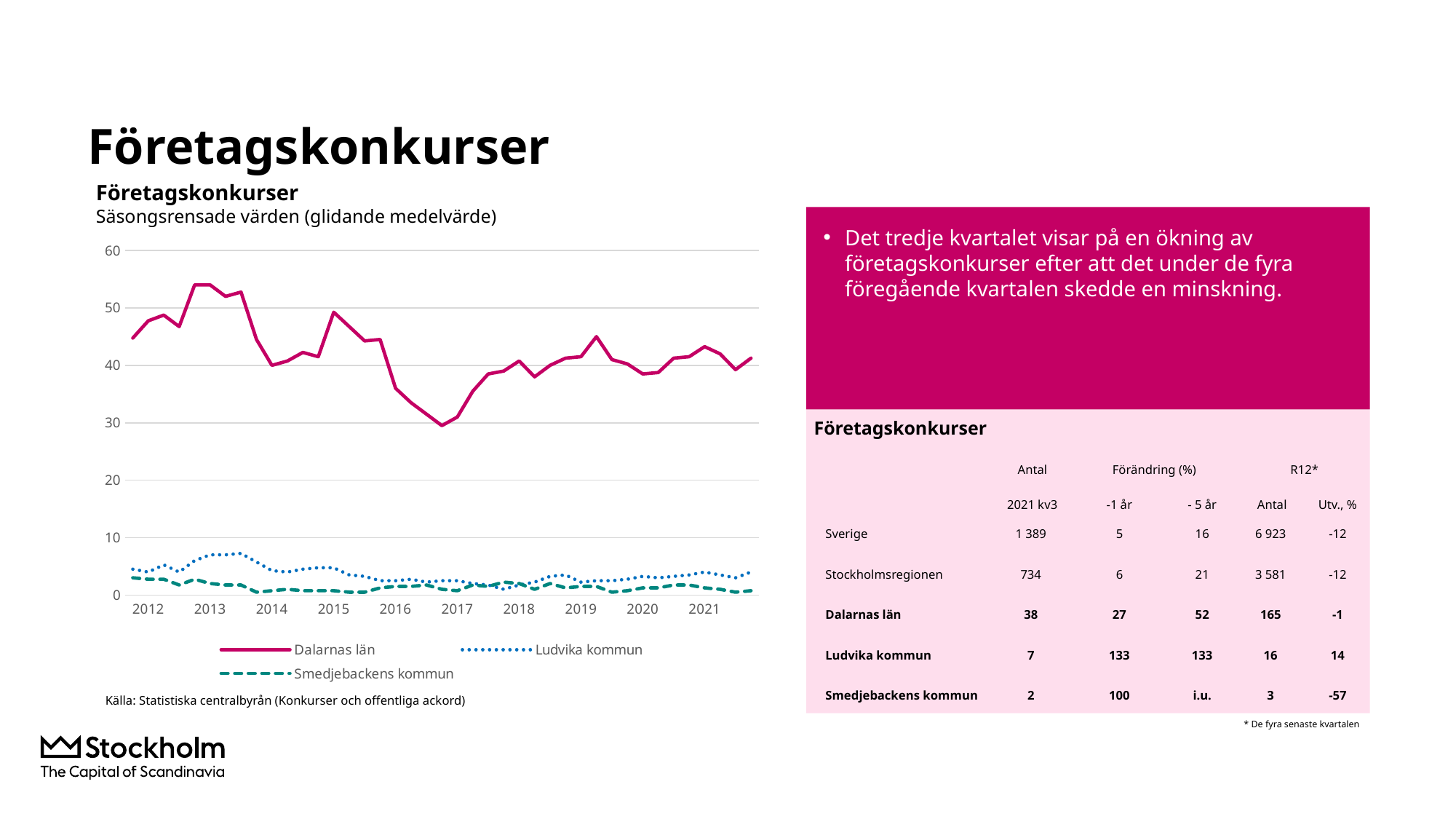
How many year labels are shown on the x axis of the chart? 10 Which series has the highest values throughout the chart? Dalarnas län Which series has larger values in 2015, Dalarnas län or Ludvika kommun? Dalarnas län Is the value for Dalarnas län at its 2013 peak greater or less than 50? greater Which series are listed in the chart legend? Dalarnas län, Ludvika kommun, Smedjebackens kommun Does the Dalarnas län line rise or fall between its 2013 peak and the start of 2017? Fall Is the value for Ludvika kommun in 2013 greater or less than 10? less What kind of chart is shown on the slide? Line chart What is the subtitle shown under the chart title "Företagskonkurser"? Säsongsrensade värden (glidande medelvärde) How many series does the chart legend list? 3 Is the value for Dalarnas län at the start of 2017 greater or less than 40? less